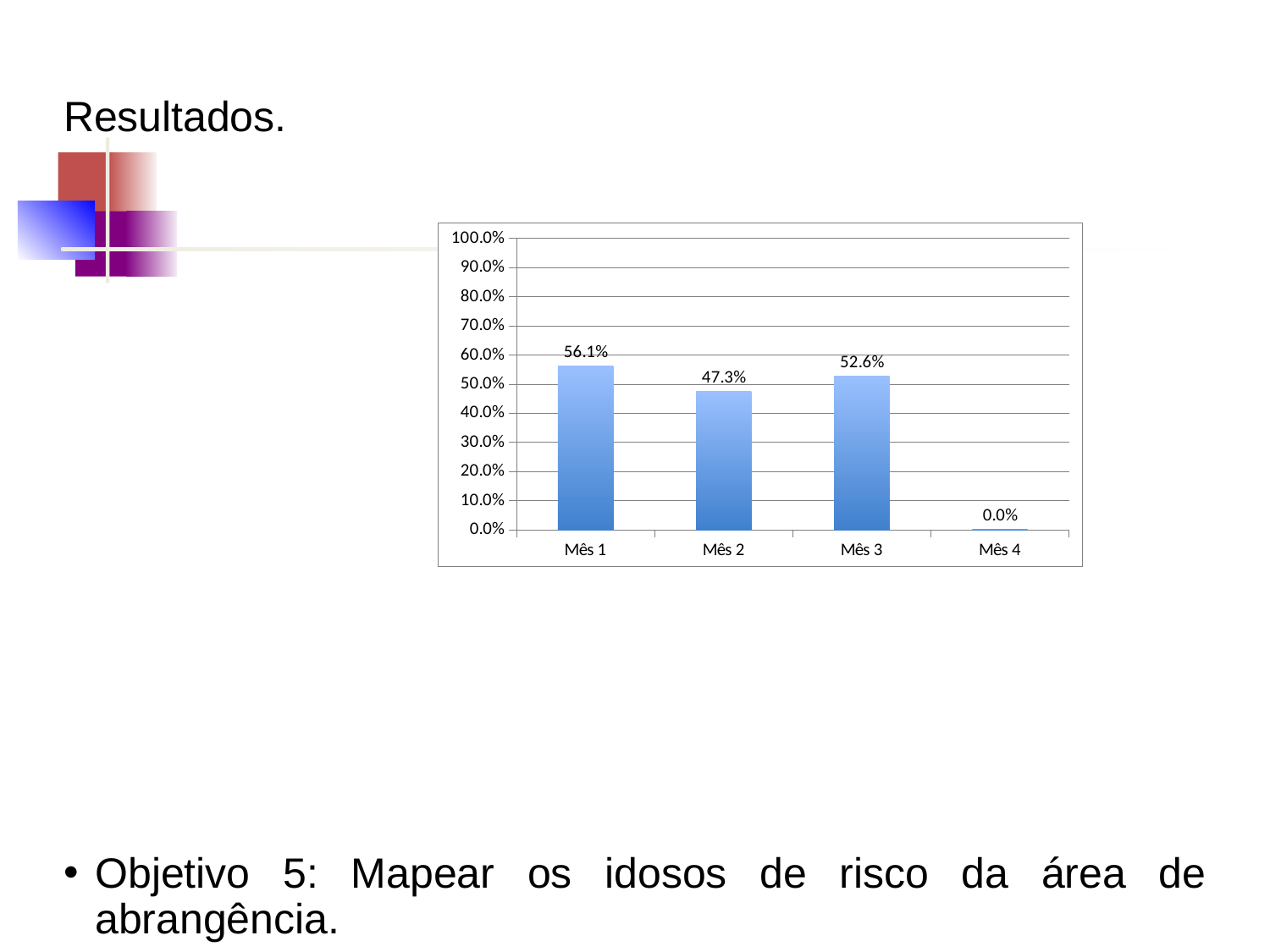
What is the value for Mês 1? 56.1% What is the value for Mês 3? 52.6% What is the difference between the values for Mês 3 and Mês 2? 5.3% What is the difference between the values for Mês 1 and Mês 2? 8.8% Which month has the highest value? Mês 1 What is the value for Mês 4? 0.0% Is the value for Mês 1 greater or less than 50.0%? greater How many categories are shown on the x axis? 4 Which is larger, the value for Mês 2 or the value for Mês 3? Mês 3 Which month has the lowest value? Mês 4 What kind of chart is shown on the slide? bar chart What is the value for Mês 2? 47.3%